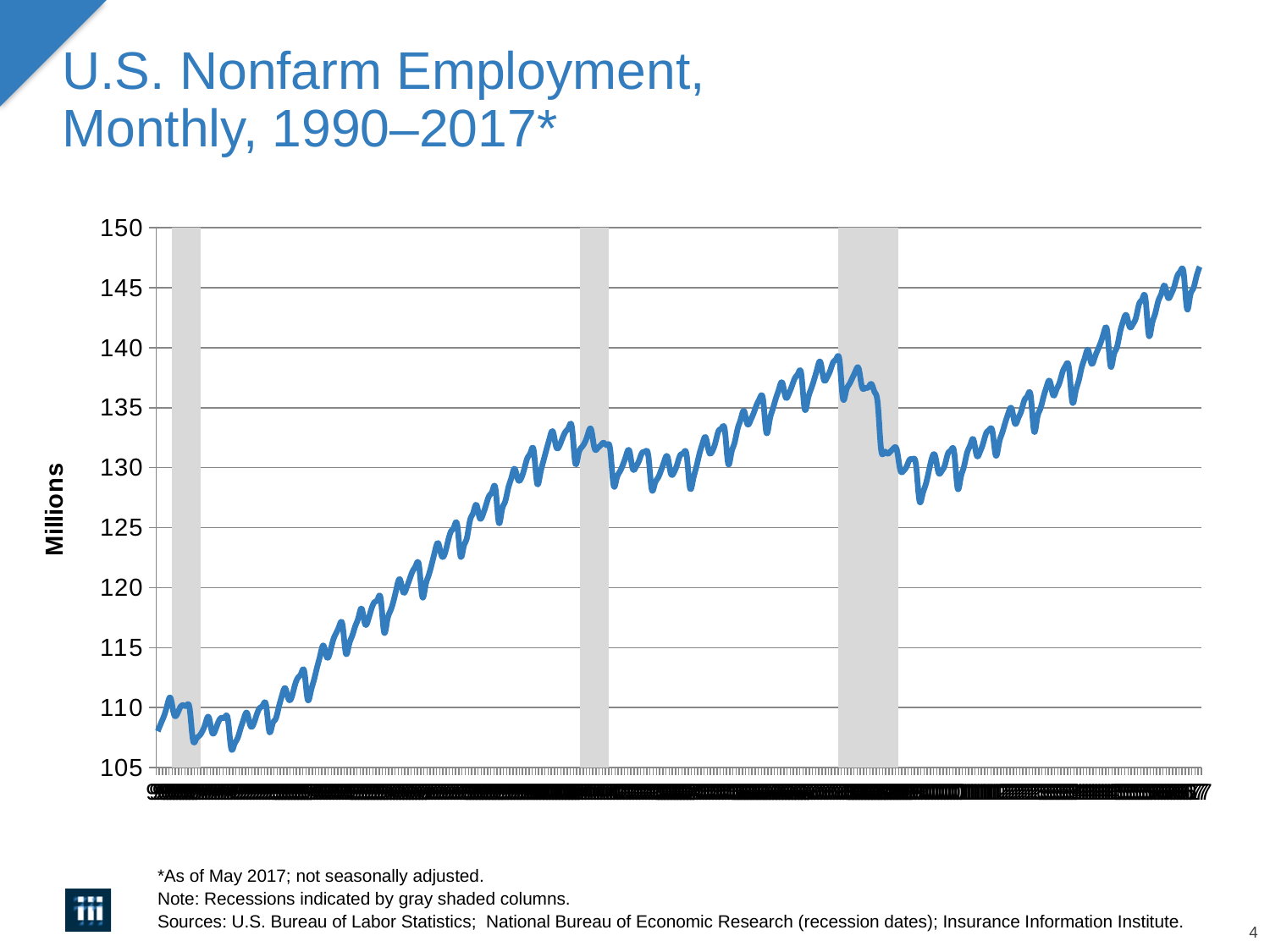
Is the lowest value plotted on the chart greater or less than 110? less What is the title of the chart? U.S. Nonfarm Employment, Monthly, 1990–2017* Is the value at the start of the series (1990) greater or less than 110? less What is the highest tick value shown on the vertical axis? 150 What is the lowest tick value shown on the vertical axis? 105 Is the value at the end of the series higher or lower than the value at the start of the series? Higher Is the value at the end of the series (May 2017) greater or less than 140? greater What kind of chart is shown on the slide? Line chart Overall, does U.S. nonfarm employment rise or fall from 1990 to 2017 along the x axis? Rise What is the label on the vertical axis of the chart? Millions